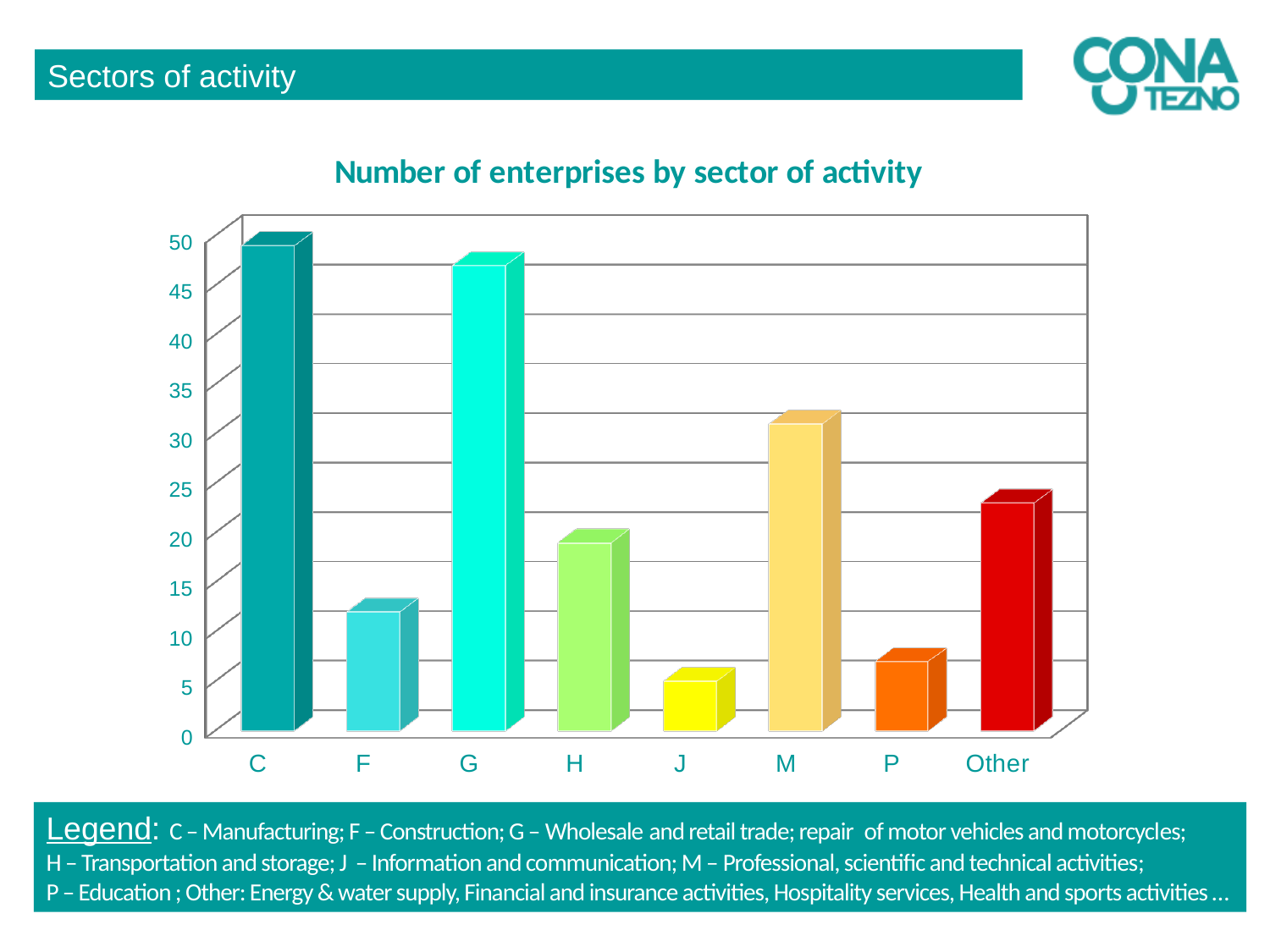
Which sector has the lowest number of enterprises? J What kind of chart is shown on the slide? bar chart What is the title of the chart? Number of enterprises by sector of activity Which has more enterprises, Other or F? Other Is the value for F greater or less than 15? less Is the value for Other greater or less than 25? less Is the value for M greater or less than 25? greater Which has more enterprises, M or H? M How many sector categories are shown on the x axis of the chart? 8